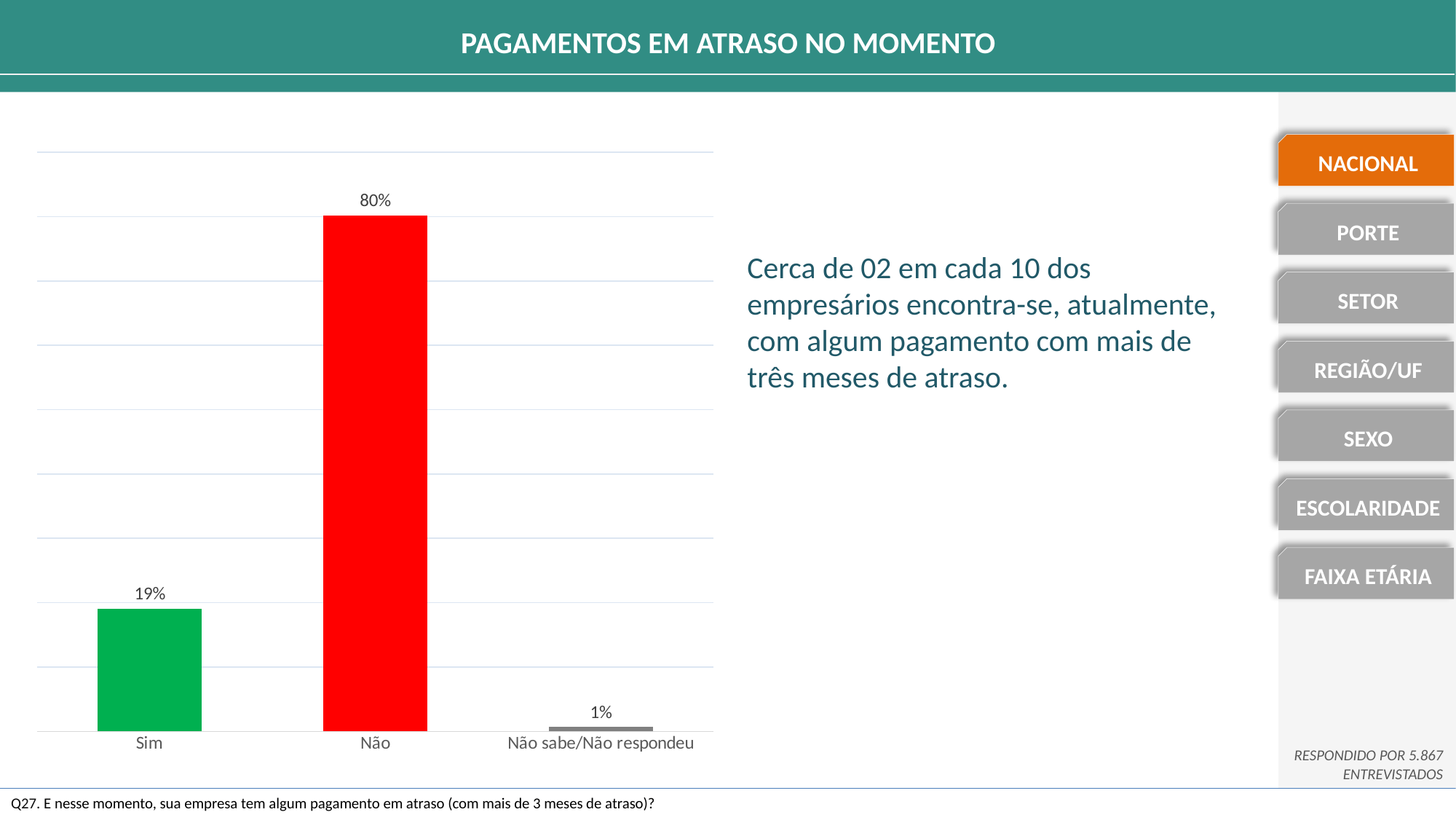
Which category has the highest value? Não What is the difference between the values for "Sim" and "Não sabe/Não respondeu"? 18% How many categories are shown in the chart? 3 What is the value for "Não sabe/Não respondeu"? 1% What kind of chart is shown on the slide? Bar chart What colour is the bar for "Não"? Red Which is larger, the value for "Sim" or the value for "Não sabe/Não respondeu"? Sim What is the difference between the values for "Não" and "Sim"? 61% Which category has the lowest value? Não sabe/Não respondeu What is the title of the slide containing the chart? PAGAMENTOS EM ATRASO NO MOMENTO What is the value for "Sim"? 19% What is the value for "Não"? 80%